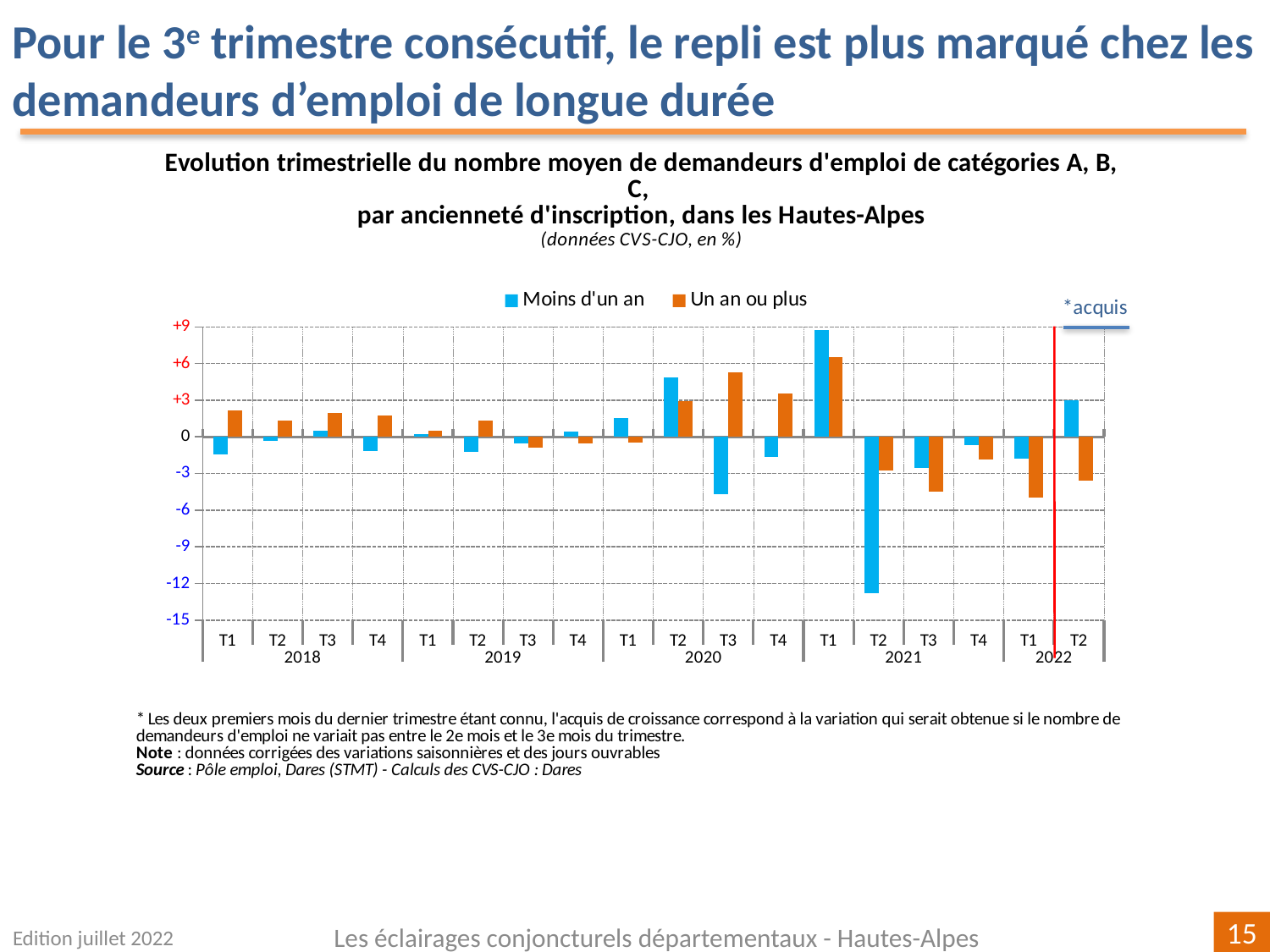
Is the value for 'Un an ou plus' in T3 2020 greater or less than +3? greater How many series does the legend list? 2 In which quarter does the 'Moins d'un an' series reach its lowest value? T2 2021 In which quarter does the 'Un an ou plus' series reach its highest value? T1 2021 Which series is drawn in orange? Un an ou plus How many quarters are plotted along the x axis? 18 Is the value for 'Moins d'un an' in T2 2021 greater or less than -12? less Is the value for 'Moins d'un an' in T1 2021 greater or less than +6? greater In which quarter does the 'Moins d'un an' series reach its highest value? T1 2021 What kind of chart is shown on the slide? bar chart In T3 2020, which series has the larger value, 'Moins d'un an' or 'Un an ou plus'? Un an ou plus What are the two series named in the legend? Moins d'un an; Un an ou plus